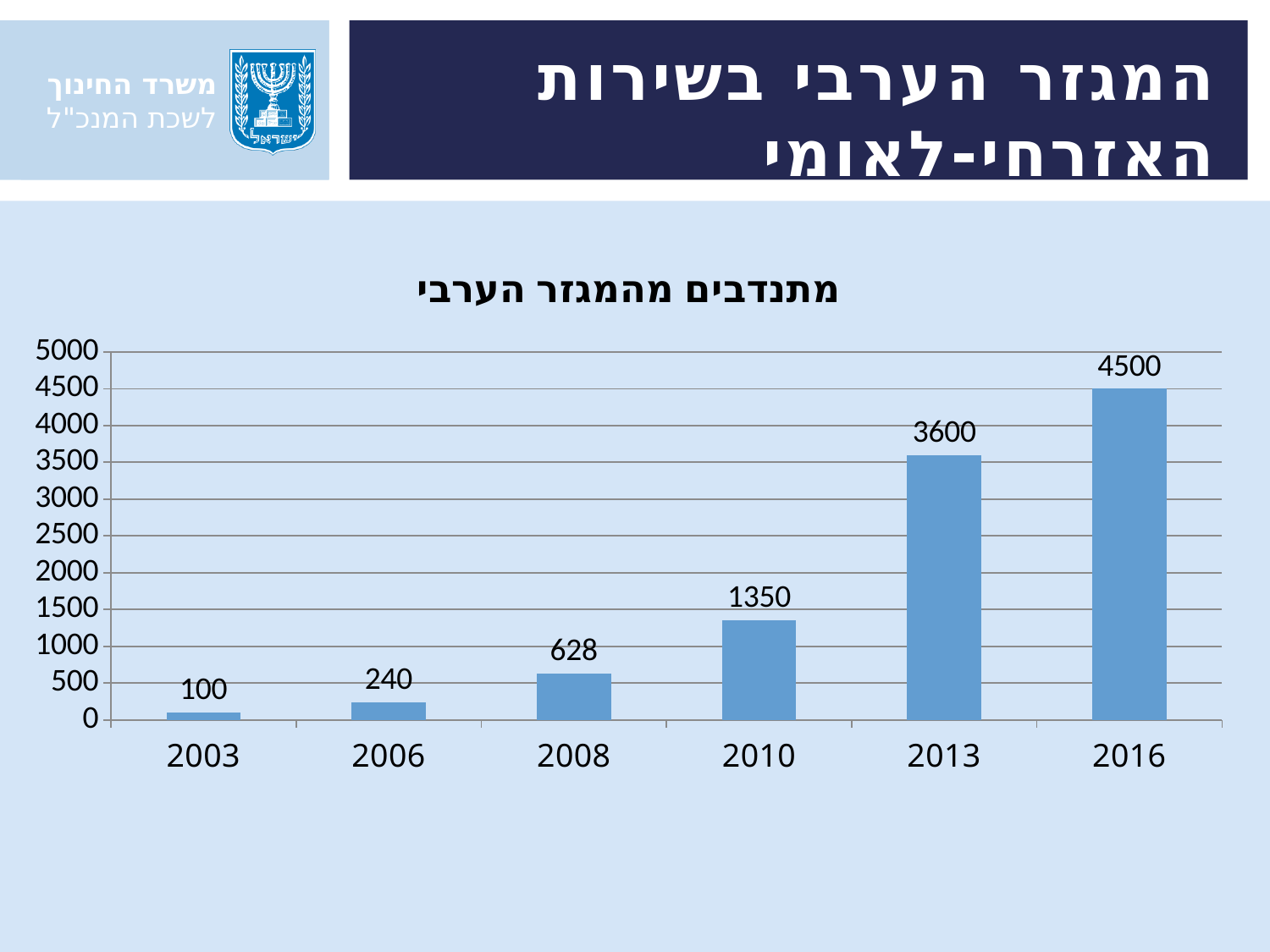
What kind of chart is this? bar chart Which is larger, the value for 2006 or the value for 2008? 2008 Do the values rise or fall from 2003 to 2016? rise What is the value for 2010? 1350 Which year has the highest value? 2016 What is the value for 2003? 100 Which year has the lowest value? 2003 What is the difference between the values for 2016 and 2013? 900 How many years are shown on the x axis? 6 What is the value for 2008? 628 Is the value for 2013 greater or less than 3000? greater What is the difference between the values for 2010 and 2008? 722